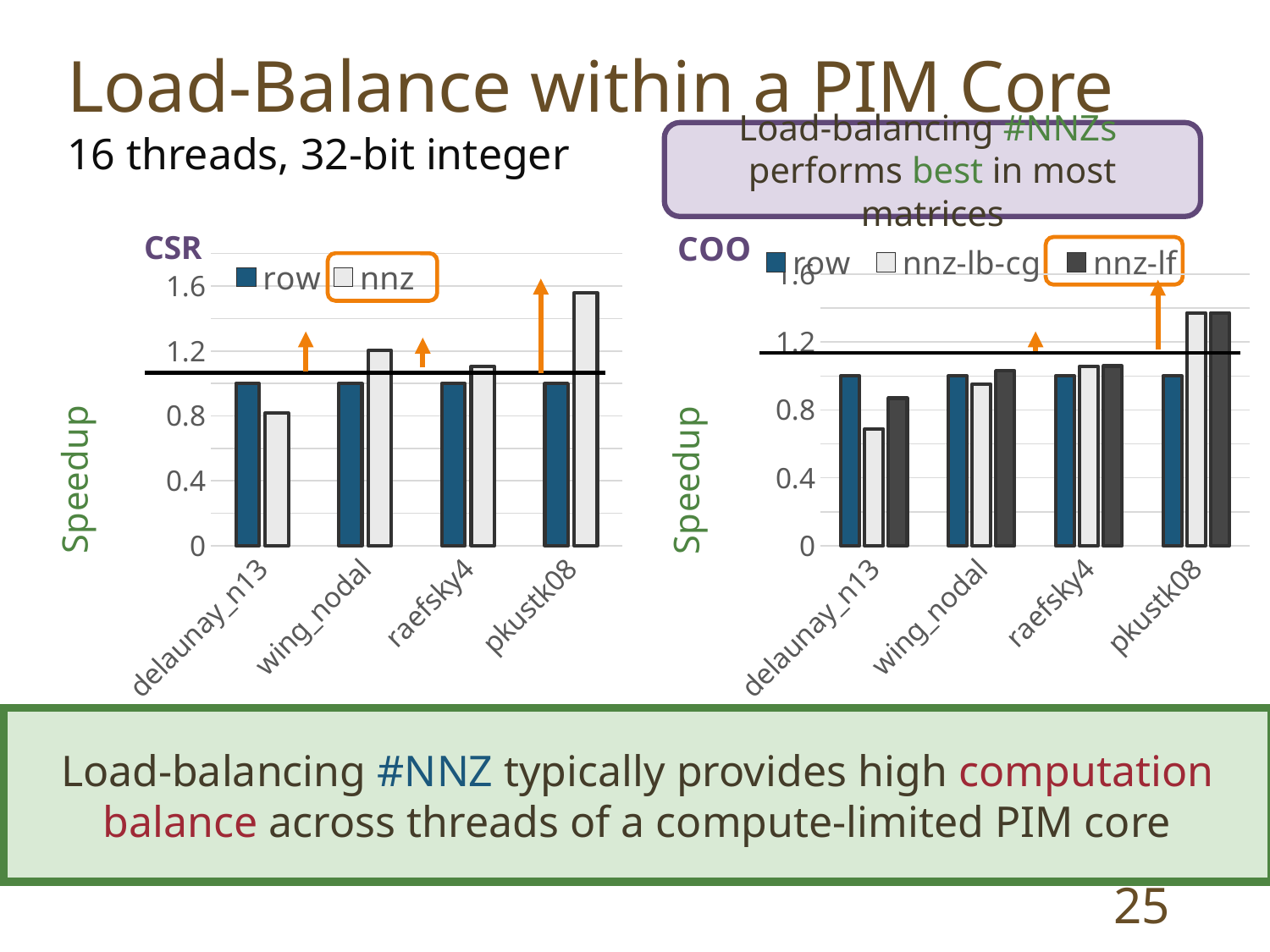
In the COO chart, is the nnz-lb-cg speedup for delaunay_n13 greater or less than 0.8? less In the CSR chart, which matrix has the lowest nnz speedup? delaunay_n13 What is the y-axis label of the COO chart? Speedup How many series does the legend of the CSR chart list? 2 How many series does the legend of the COO chart list? 3 What kind of chart is the CSR chart on the left? bar chart In the CSR chart, is the nnz speedup for delaunay_n13 greater or less than 1.2? less How many matrices (categories) are shown on the x axis of the CSR chart? 4 In the CSR chart, for delaunay_n13, which is larger: the row bar or the nnz bar? row In the CSR chart, is the nnz speedup for pkustk08 greater or less than 1.2? greater In the COO chart, which matrix has the highest nnz-lf speedup? pkustk08 In the CSR chart, which matrix has the highest nnz speedup? pkustk08